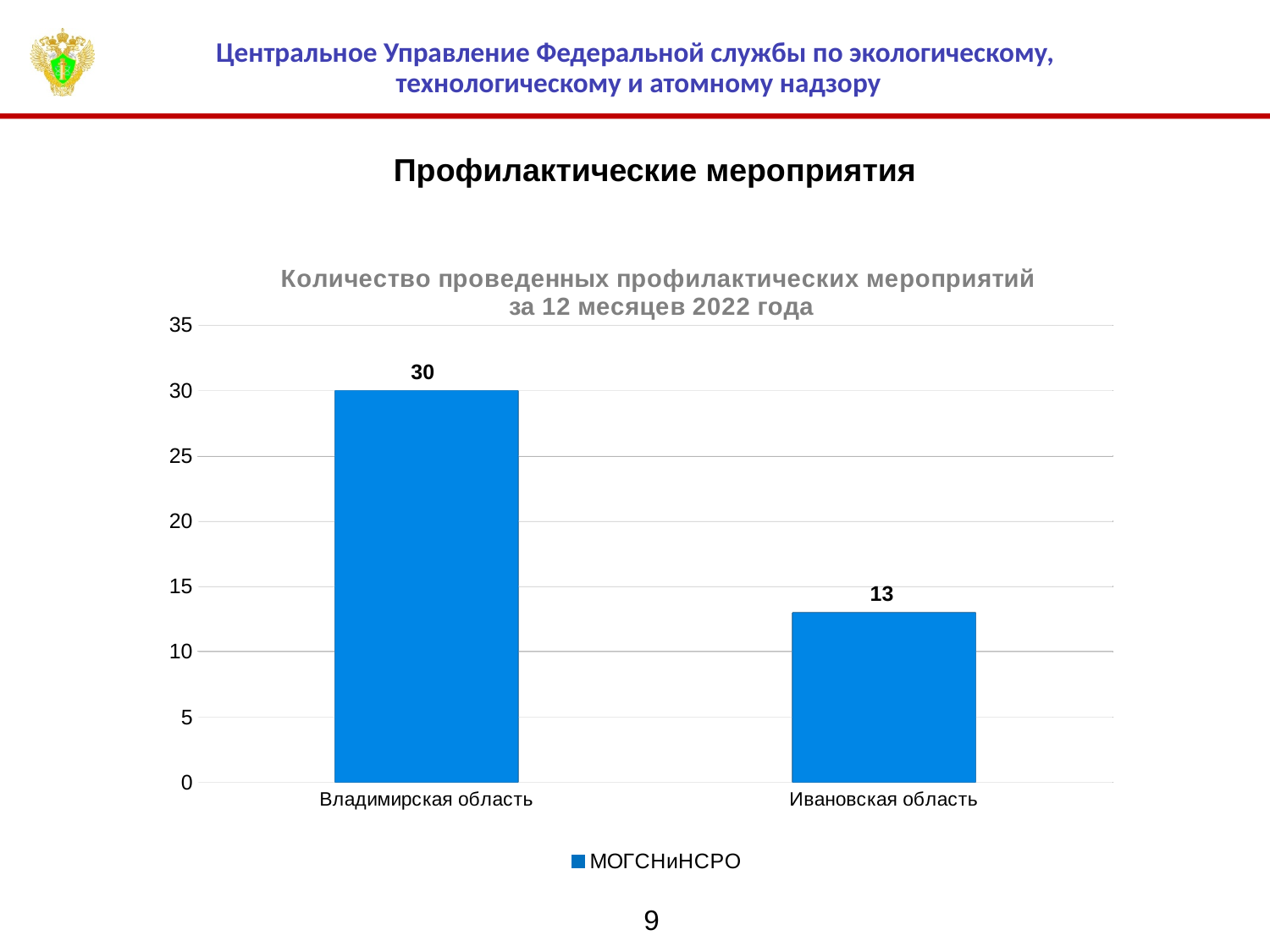
What is the title of the chart? Количество проведенных профилактических мероприятий за 12 месяцев 2022 года How many series does the legend list? 1 What is the difference between the values for Владимирская область and Ивановская область? 17 What is the value for Владимирская область? 30 What series name is shown in the legend? МОГСНиНСРО Which category has the highest value? Владимирская область Which category has the lowest value? Ивановская область How many categories are shown on the chart? 2 What kind of chart is shown on the slide? bar chart Which is larger, the value for Владимирская область or the value for Ивановская область? Владимирская область What is the value for Ивановская область? 13 Is the value for Ивановская область greater or less than 15? less